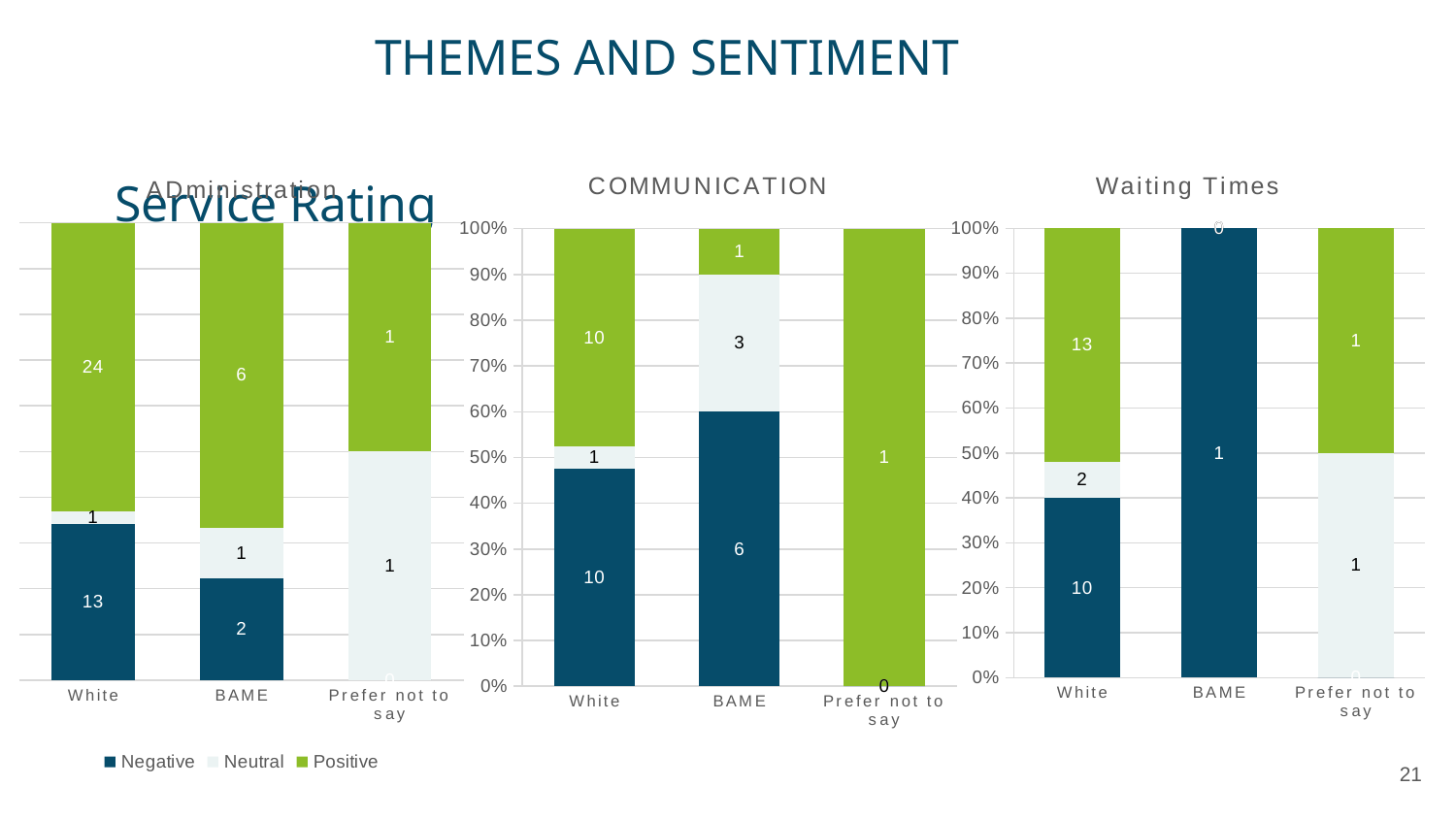
In the Administration chart on the left, how many Positive responses are shown for White? 24 In the COMMUNICATION chart, is the Negative count for BAME larger or smaller than the Positive count for BAME? larger In the Administration chart on the left, how many Negative responses are shown for BAME? 2 In the COMMUNICATION chart, how many Neutral responses are shown for BAME? 3 In the COMMUNICATION chart, how many Negative responses are shown for White? 10 In the Administration chart on the left, what is the difference between the Positive and Negative counts for White? 11 In the Waiting Times chart, how many Positive responses are shown for White? 13 In the Waiting Times chart, which category has the highest Positive count? White How many series does the legend list? 3 In the Waiting Times chart, how many Neutral responses are shown for White? 2 In the COMMUNICATION chart, what is the total number of responses in the BAME bar? 10 How many categories are shown on the x axis of the Waiting Times chart? 3